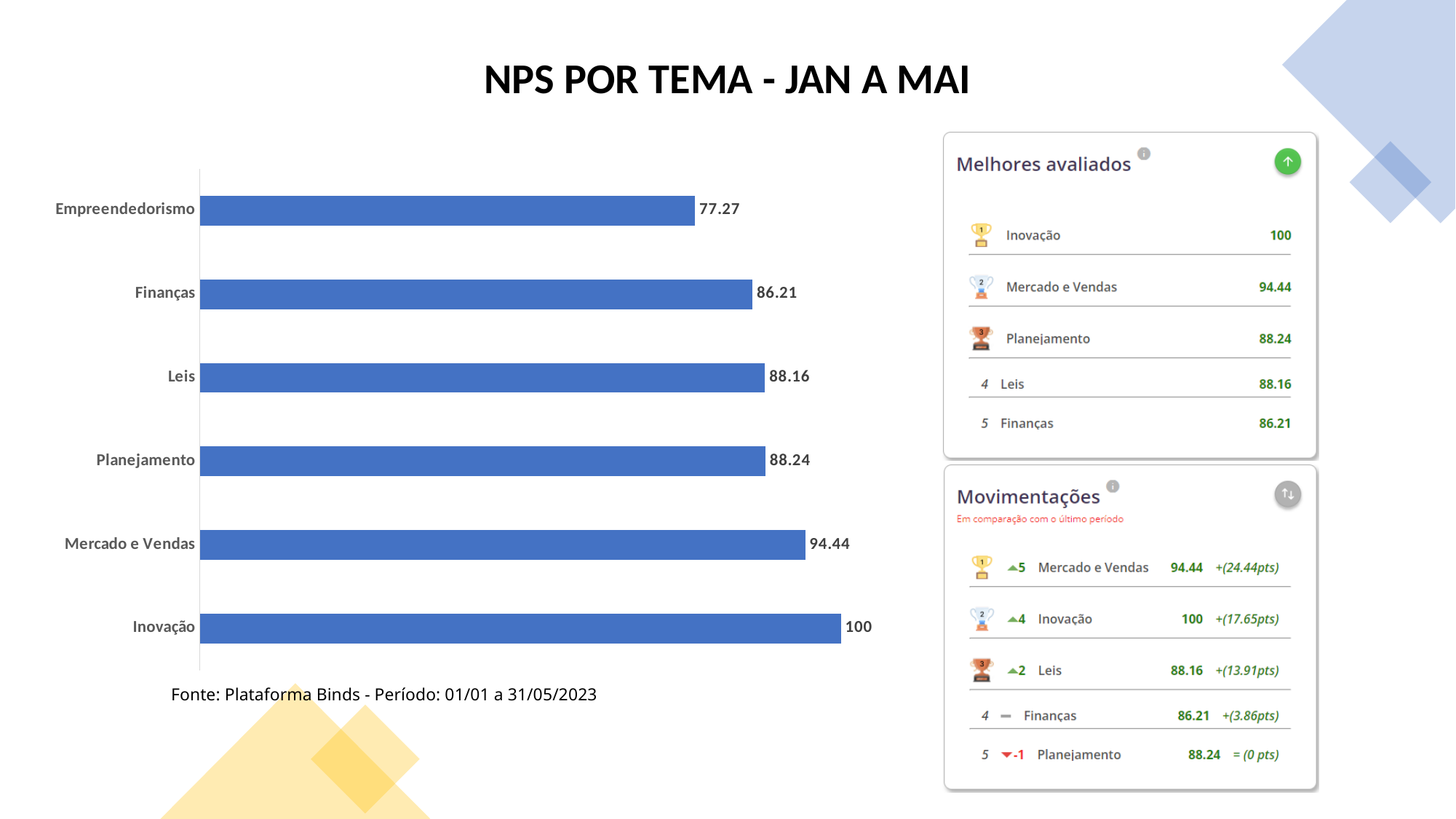
What is the NPS value for Empreendedorismo in the bar chart? 77.27 Which theme has the highest NPS in the bar chart? Inovação How many themes are shown in the bar chart? 6 What is the NPS value for Mercado e Vendas in the bar chart? 94.44 What is the difference between the NPS for Inovação and the NPS for Empreendedorismo? 22.73 What colour are the bars in the chart? Blue What is the title of the slide's chart? NPS POR TEMA - JAN A MAI What is the difference between the NPS for Planejamento and the NPS for Leis? 0.08 What is the NPS value for Finanças in the bar chart? 86.21 Which theme has the lowest NPS in the bar chart? Empreendedorismo Which has a higher NPS, Mercado e Vendas or Finanças? Mercado e Vendas What kind of chart is used to show NPS by theme? Bar chart